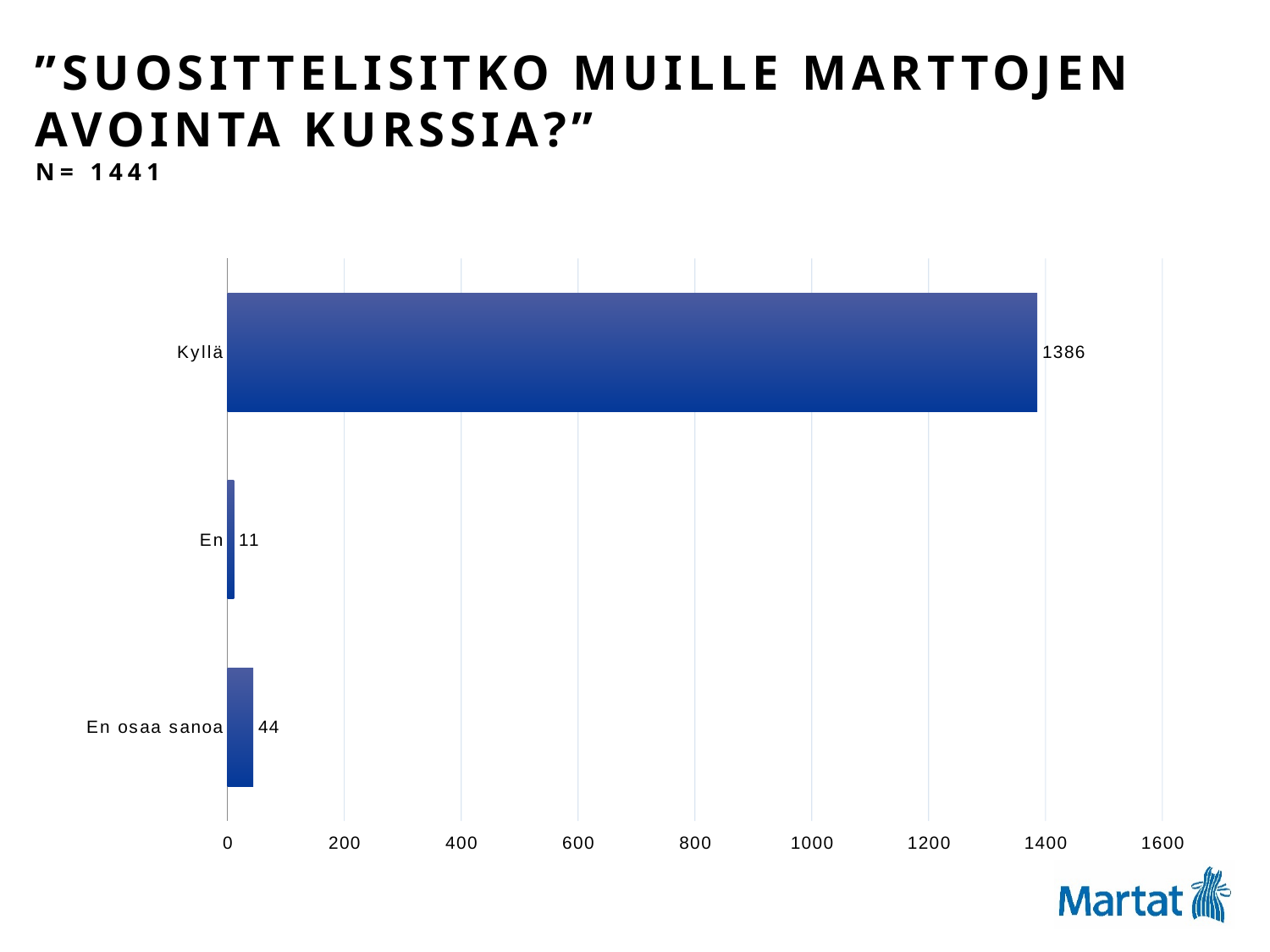
What is the N value stated on the slide? 1441 What is the value for En osaa sanoa? 44 Which is larger, the value for En or the value for En osaa sanoa? En osaa sanoa What is the value for Kyllä? 1386 Which category has the highest value? Kyllä Which category has the lowest value? En Is the value for Kyllä greater or less than 1200? greater What is the value for En? 11 What is the difference between the values for En osaa sanoa and En? 33 How many categories are shown in the chart? 3 What kind of chart is shown on the slide? bar chart What is the difference between the values for Kyllä and En osaa sanoa? 1342